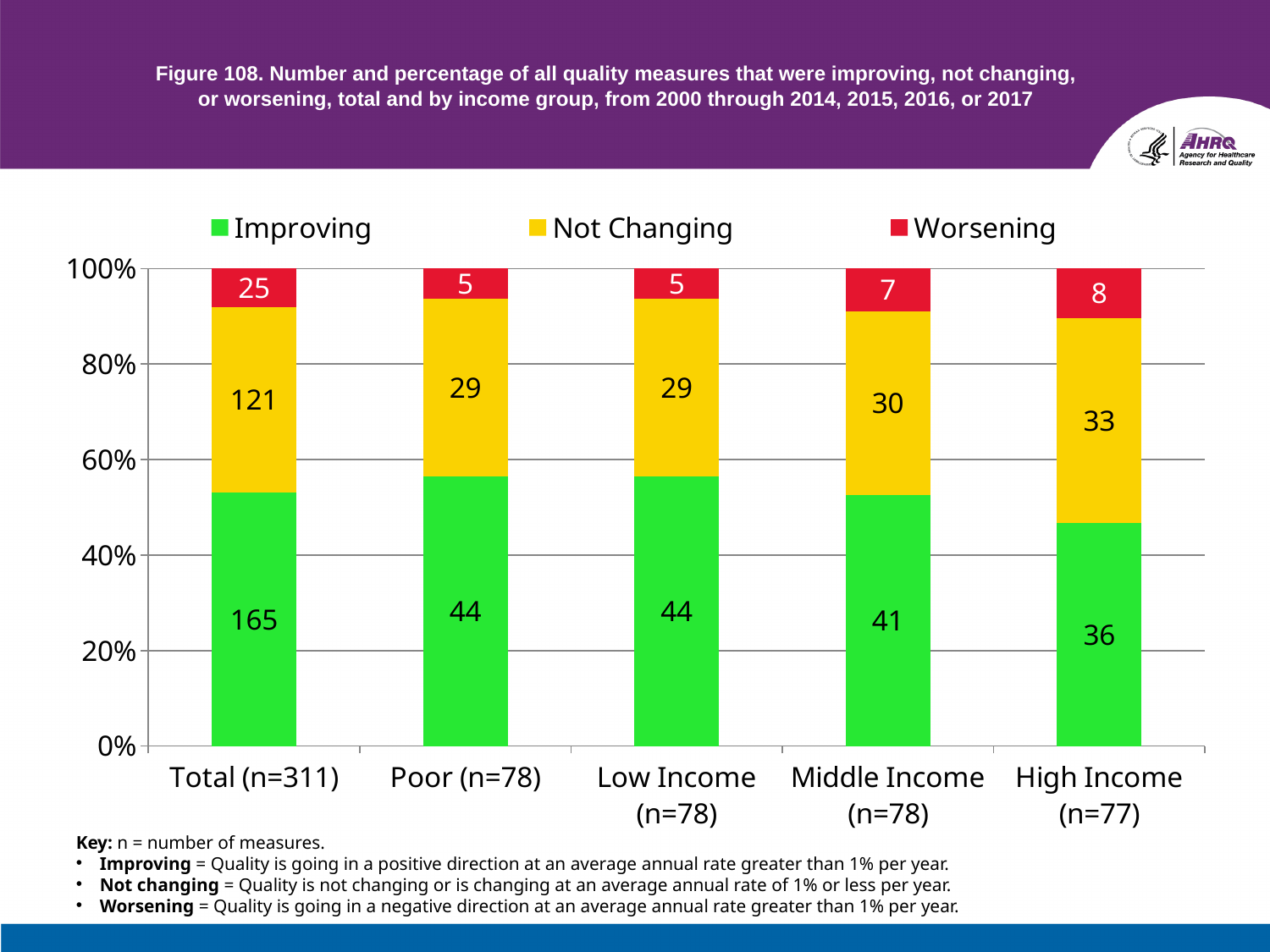
How many series does the legend list? 3 Which income group has the highest number of Worsening measures (excluding Total)? High Income (n=77) Is the Improving share of the High Income (n=77) bar greater or less than 60%? less How many categories are shown on the x axis? 5 What is the difference between the number of Improving measures for Poor (n=78) and High Income (n=77)? 8 What is the total number of measures in the Poor (n=78) bar, summing Improving, Not Changing, and Worsening? 78 How many quality measures were Improving for the Total (n=311) group? 165 What kind of chart is shown on the slide? Stacked bar chart How many quality measures were Not Changing for the High Income (n=77) group? 33 Which income group has the lowest number of Improving measures? High Income (n=77) How many quality measures were Worsening for the Middle Income (n=78) group? 7 Which is larger: the number of Not Changing measures for Middle Income (n=78) or for Low Income (n=78)? Middle Income (n=78)